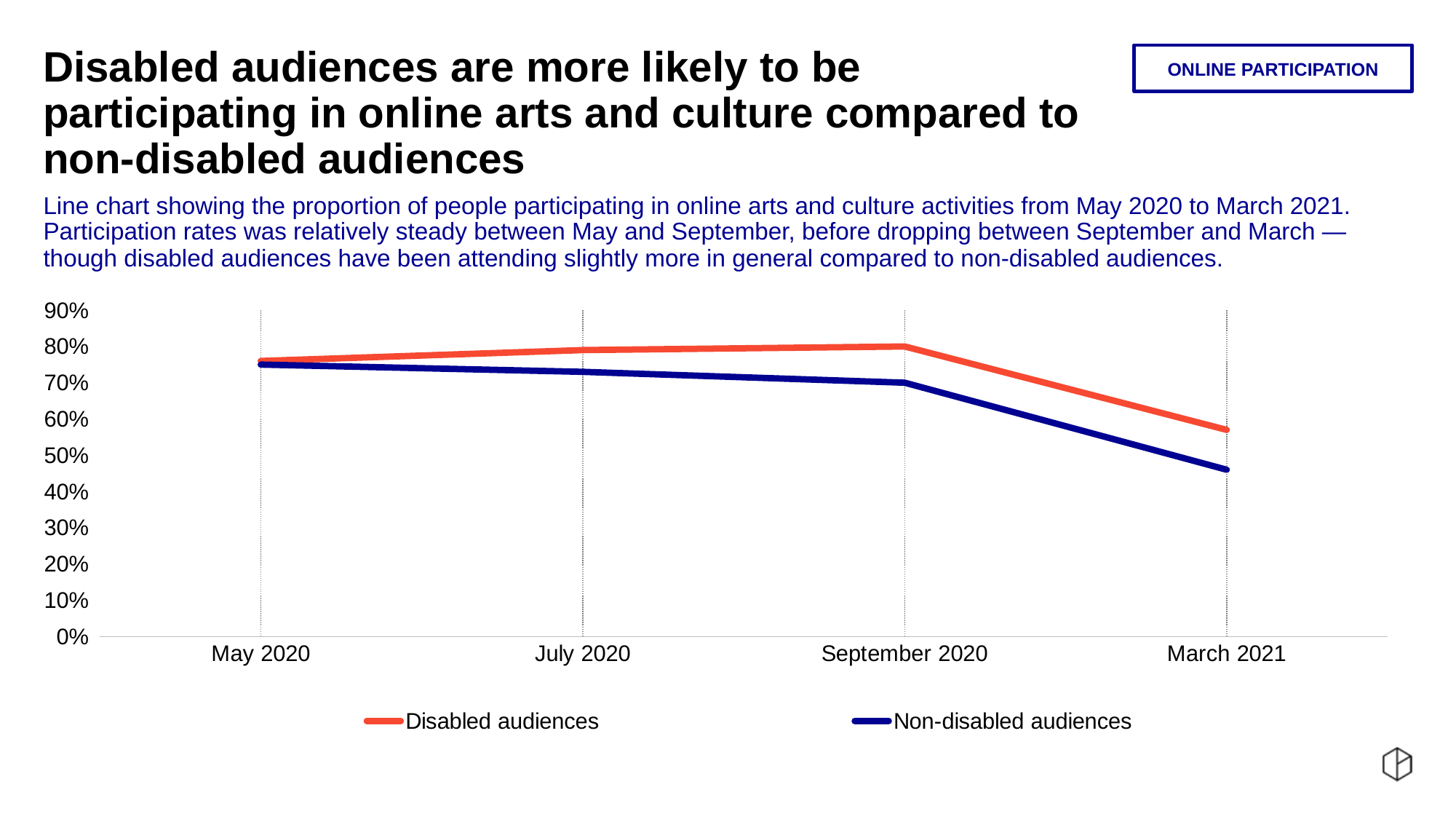
How many time points are plotted along the x axis? 4 Does the Non-disabled audiences line rise or fall from May 2020 to March 2021? Fall At which time point is the value for Non-disabled audiences lowest? March 2021 Is the value for Non-disabled audiences in March 2021 greater or less than 50%? less Is the value for Non-disabled audiences in July 2020 greater or less than 80%? less Is the value for Disabled audiences in March 2021 greater or less than 50%? greater At which time point is the value for Disabled audiences lowest? March 2021 What kind of chart is shown on the slide? Line chart Which series is drawn in orange in the legend? Disabled audiences How many series does the legend list? 2 In March 2021, which series has the higher value, Disabled audiences or Non-disabled audiences? Disabled audiences